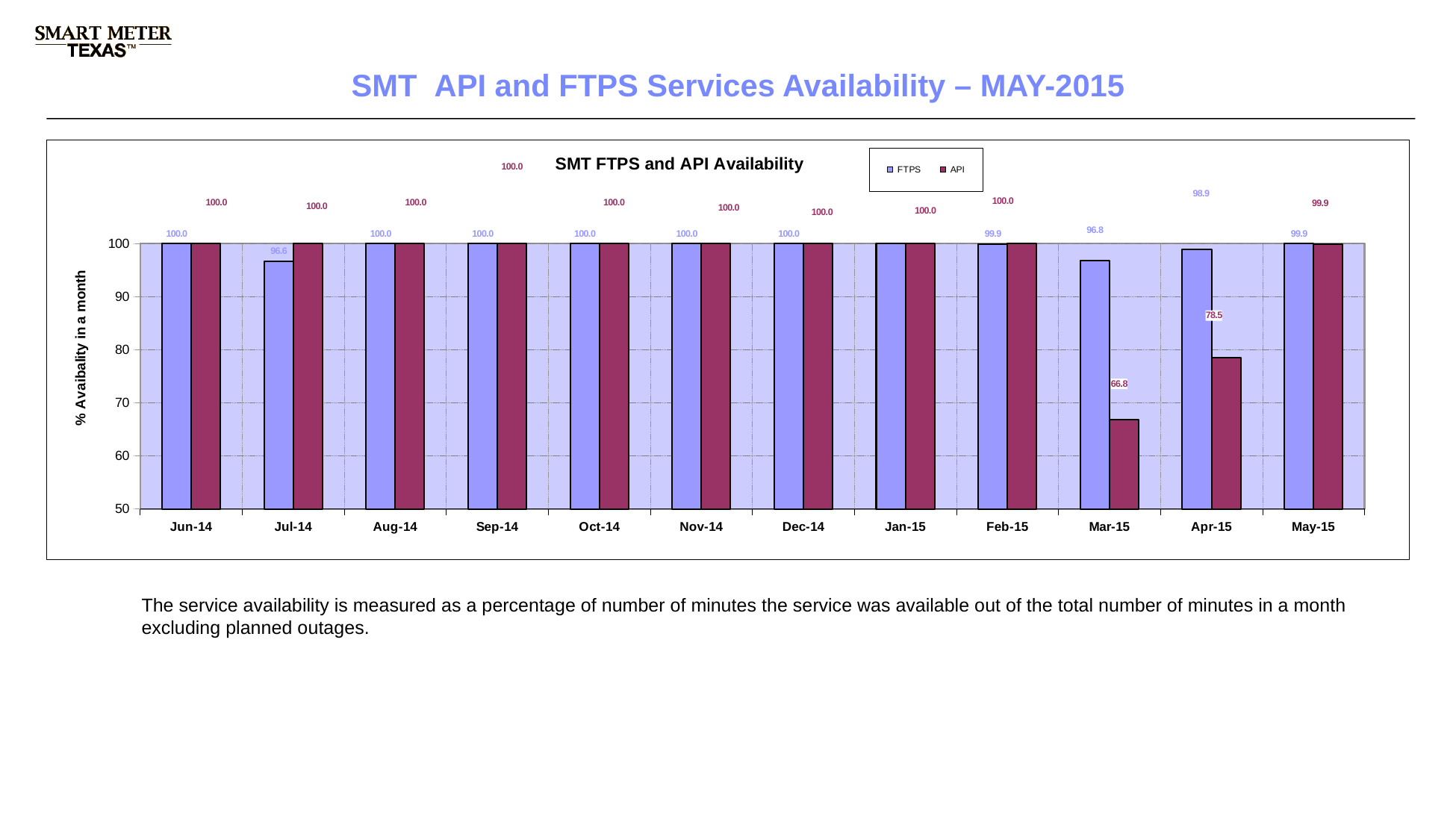
What is the API availability value for Mar-15? 66.8 Is the API availability value for Mar-15 greater or less than 70? less What is the API availability value for Apr-15? 78.5 How many months are shown on the x axis of the chart? 12 What is the FTPS availability value for Jul-14? 96.6 What kind of chart is shown on the slide? bar chart In which month is the API availability lowest? Mar-15 For Mar-15, which series has the larger value, FTPS or API? FTPS What is the title of the chart? SMT FTPS and API Availability How many series does the chart legend list? 2 What is the FTPS availability value for Apr-15? 98.9 What is the difference between the FTPS and API availability values for Apr-15? 20.4